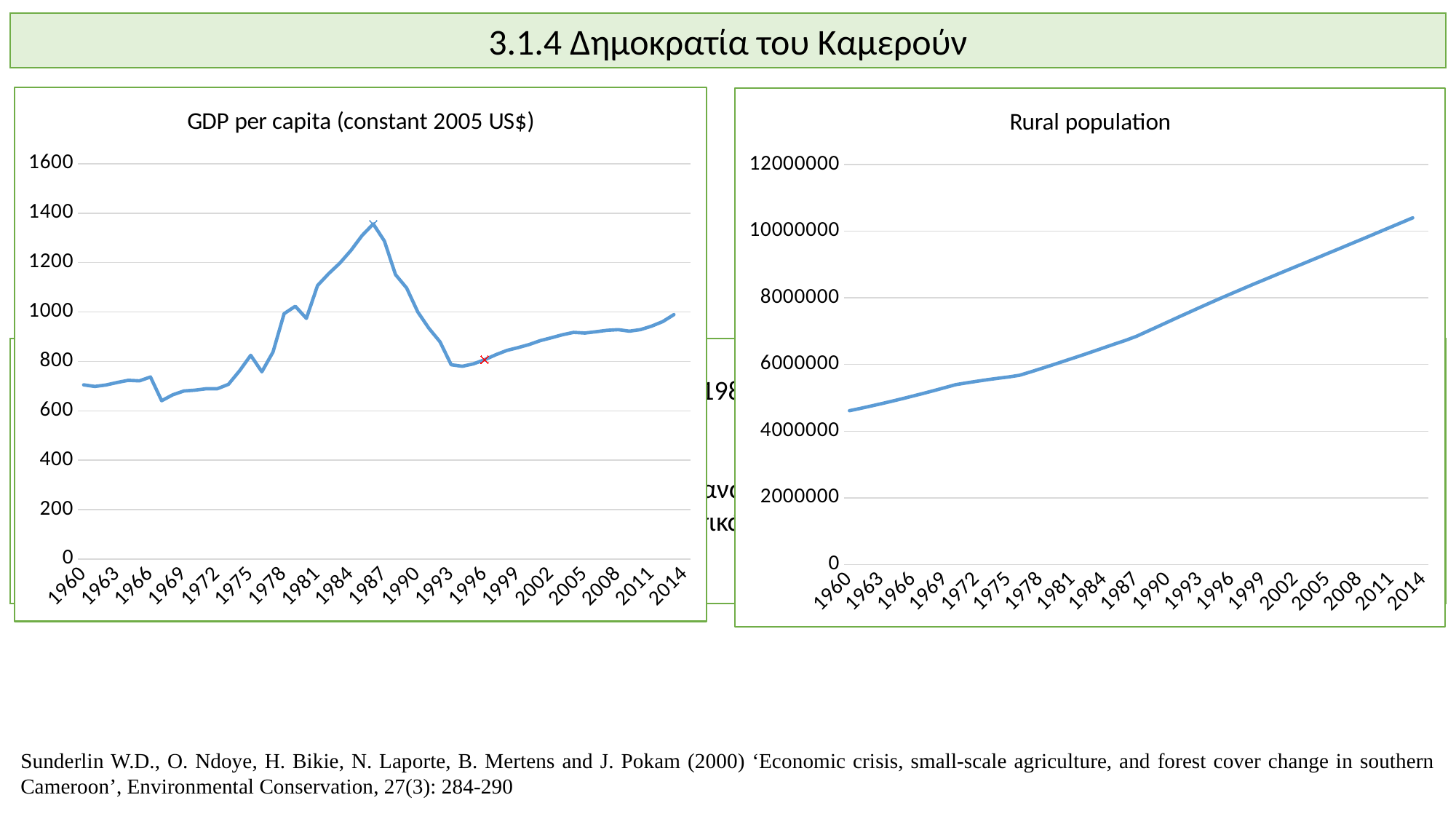
In the 'Rural population' chart, do the values rise or fall from 1960 to 2014? rise What kind of chart is the 'Rural population' chart? line chart In the 'Rural population' chart, is the value for 1987 greater or less than 8000000? less In the 'GDP per capita (constant 2005 US$)' chart, is the value for 1984 larger or smaller than the value for 1996? larger In the 'GDP per capita (constant 2005 US$)' chart, do the values rise or fall between 1987 and 1993? fall In the 'GDP per capita (constant 2005 US$)' chart, is the value for 1987 greater or less than 1200? greater What kind of chart is the 'GDP per capita (constant 2005 US$)' chart? line chart What is the title of the chart on the right side of the slide? Rural population In the 'GDP per capita (constant 2005 US$)' chart, is the value for 1960 greater or less than 800? less In the 'GDP per capita (constant 2005 US$)' chart, which year has the highest value? 1986